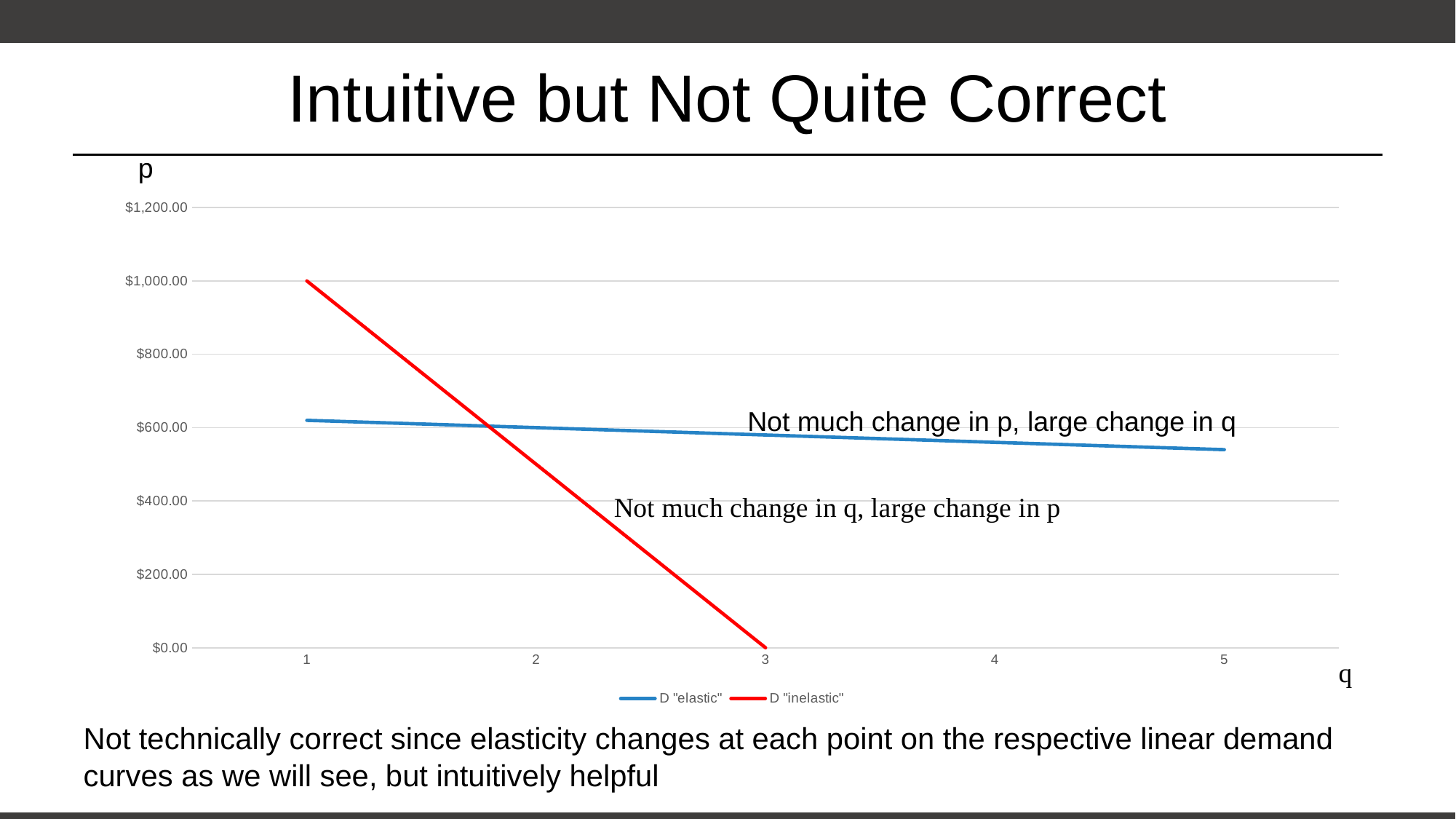
What colour is the D "inelastic" line? red What is the value of D "inelastic" at q = 3? $0.00 By how much does D "inelastic" fall between q = 1 and q = 3? $1,000.00 Is the value of D "elastic" at q = 5 greater or less than $600.00? less Is the value of D "elastic" at q = 1 greater or less than $600.00? greater How many series does the legend list? 2 How many tick values are labelled on the q axis? 5 What kind of chart is shown on the slide? line chart Does the D "inelastic" line rise or fall as q increases? fall What are the two series named in the legend? D "elastic" and D "inelastic" What is the value of D "inelastic" at q = 1? $1,000.00 At q = 1, which series has the higher value, D "elastic" or D "inelastic"? D "inelastic"